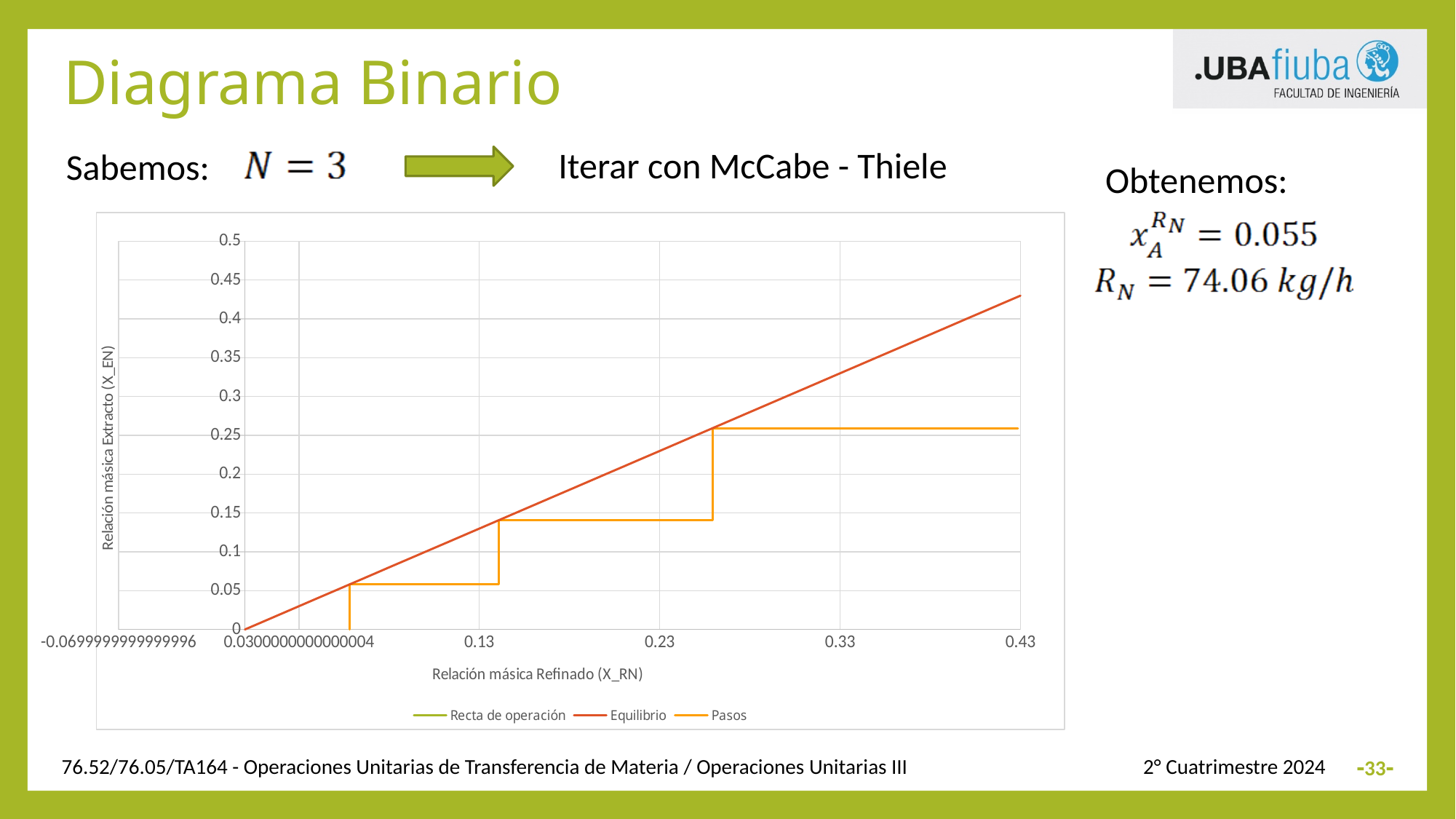
Is the value of the Equilibrio line at x = 0.43 greater or less than 0.4? greater How many series does the chart legend list? 3 What are the three series named in the chart legend? Recta de operación, Equilibrio, Pasos What is the title of the vertical axis of the chart? Relación másica Extracto (X_EN) What kind of chart is shown on the slide? line chart How many steps does the Pasos series draw between the lines on the chart? 3 What is the highest tick value shown on the vertical axis of the chart? 0.5 What is the highest tick value shown on the horizontal axis of the chart? 0.43 Is the value of the Equilibrio line at x = 0.13 greater or less than 0.1? greater Does the Equilibrio line rise or fall as the x axis value increases? rises Is the height of the topmost horizontal step of the Pasos series greater or less than 0.3? less